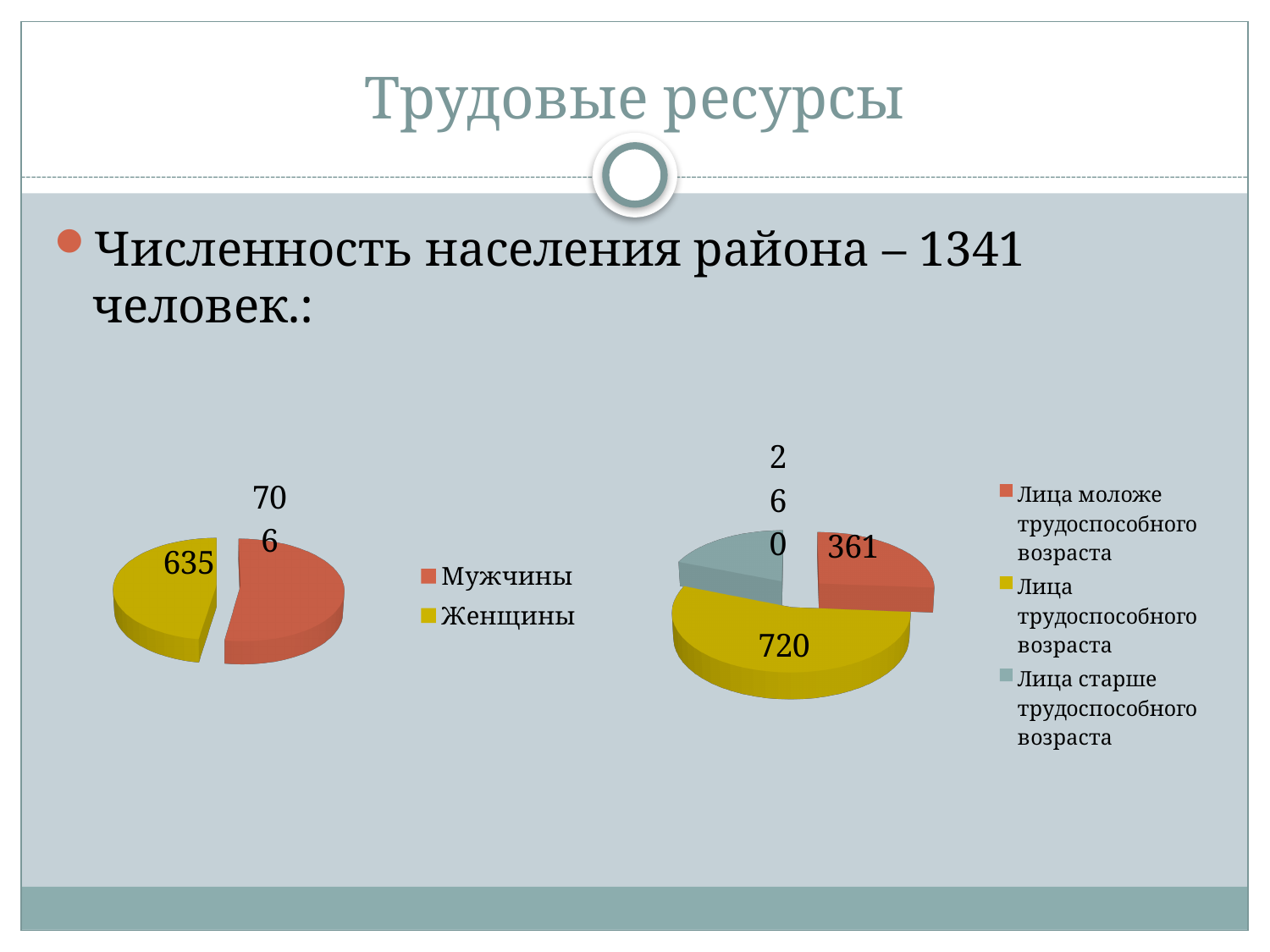
In the right pie chart, what is the value for Лица моложе трудоспособного возраста? 361 In the left pie chart, what is the value for Женщины? 635 In the left pie chart, what is the value for Мужчины? 706 In the right pie chart, what is the difference between the values for Лица трудоспособного возраста and Лица моложе трудоспособного возраста? 359 In the right pie chart, what is the value for Лица трудоспособного возраста? 720 In the left pie chart, what is the difference between the values for Мужчины and Женщины? 71 How many entries does the legend of the left pie chart list? 2 How many categories does the right pie chart show? 3 What kind of chart is the left chart with the legend Мужчины and Женщины? pie chart In the left pie chart, which is larger, Мужчины or Женщины? Мужчины In the right pie chart, which category has the highest value? Лица трудоспособного возраста In the right pie chart, which category has the lowest value? Лица старше трудоспособного возраста